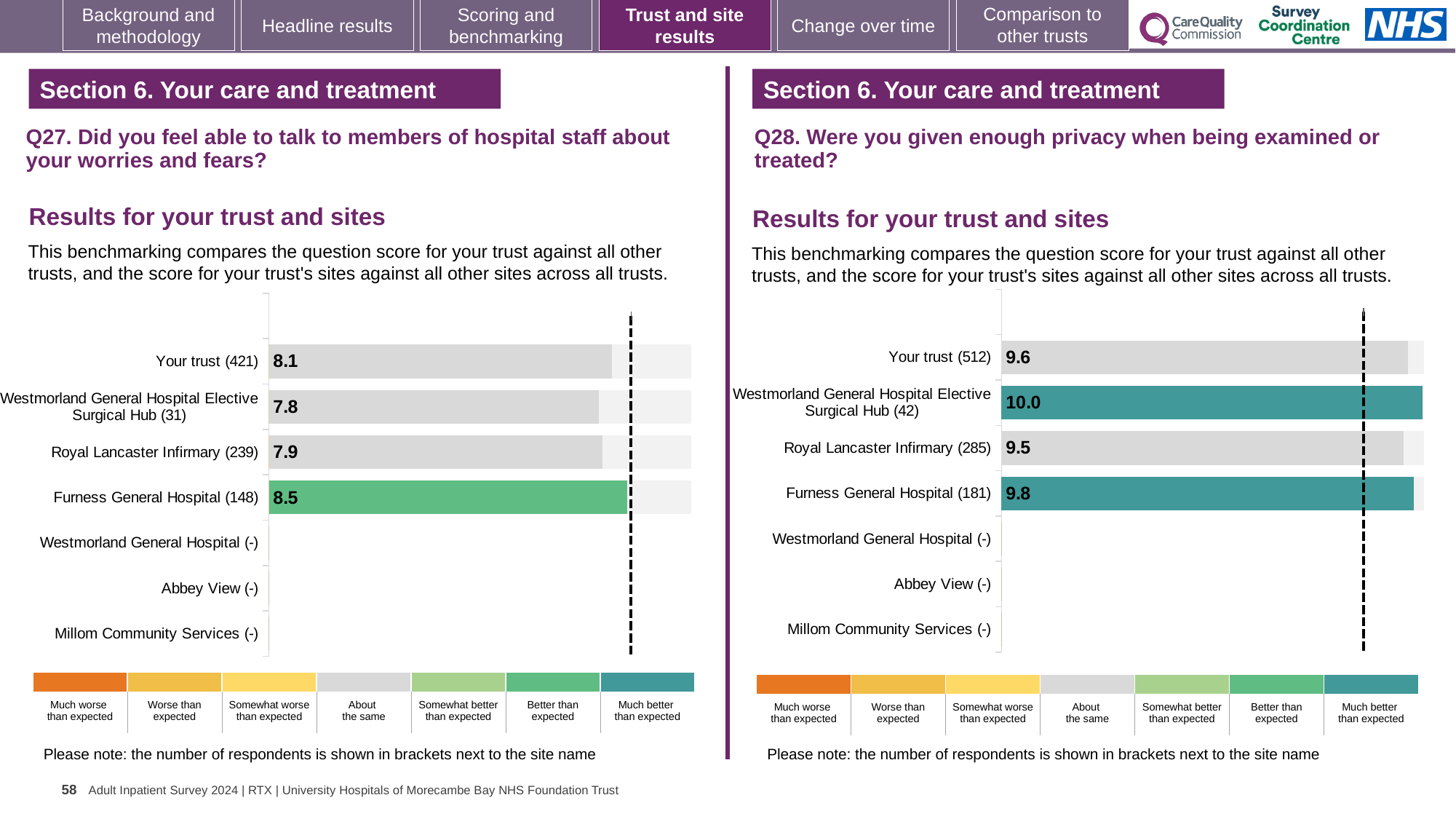
On the Q28 chart (right), which is larger: the score for Your trust (512) or Furness General Hospital (181)? Furness General Hospital (181) What kind of chart is used on the Q27 chart (left)? Bar chart On the Q28 chart (right), what is the score for Royal Lancaster Infirmary (285)? 9.5 On the Q27 chart (left), what is the score for Your trust (421)? 8.1 On the Q27 chart (left), what is the score for Furness General Hospital (148)? 8.5 On the Q27 chart (left), which site has the highest score? Furness General Hospital (148) On the Q28 chart (right), which site has the highest score? Westmorland General Hospital Elective Surgical Hub (42) On the Q28 chart (right), how many sites have a score shown as a bar? 4 On the Q28 chart (right), what is the score for Westmorland General Hospital Elective Surgical Hub (42)? 10.0 On the Q27 chart (left), which site has the lowest score? Westmorland General Hospital Elective Surgical Hub (31) On the Q28 chart (right), what is the difference between the scores for Your trust (512) and Royal Lancaster Infirmary (285)? 0.1 On the Q27 chart (left), what is the difference between the scores for Furness General Hospital (148) and Royal Lancaster Infirmary (239)? 0.6